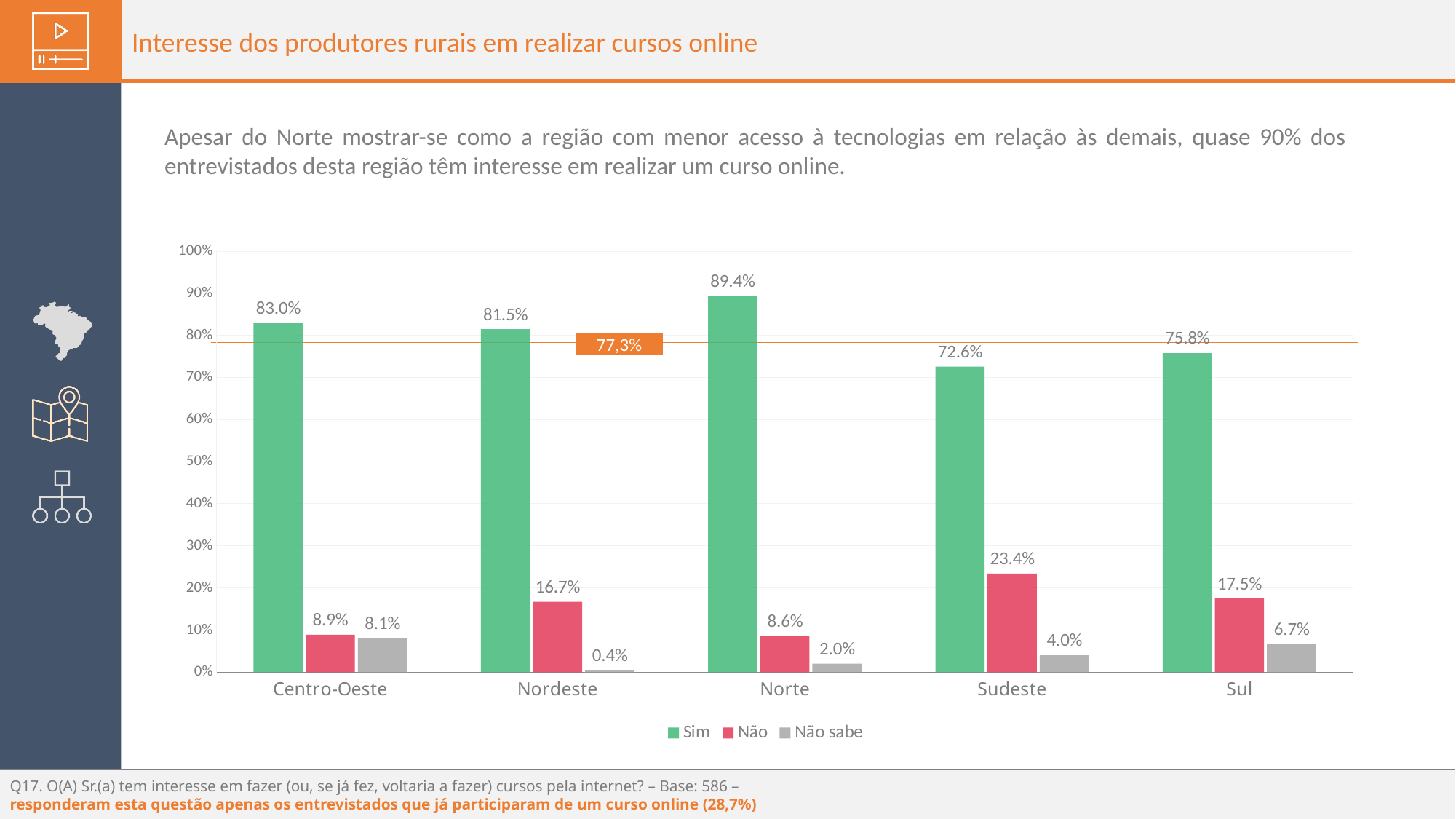
What is the value of "Não sabe" for Nordeste? 0.4% Which is larger, the "Não" value for Nordeste or for Sul? Sul How many regions are shown on the x axis? 5 Is the "Sim" value for Sudeste greater or less than 80%? less What kind of chart is shown on the slide? bar chart How many series does the legend list? 3 What is the value of "Sim" for Norte? 89.4% What is the value of "Não" for Sudeste? 23.4% Which region has the lowest "Sim" value? Sudeste What is the difference between the "Sim" values for Centro-Oeste and Sul? 7.2% What value is shown on the orange horizontal reference line? 77,3% Which region has the highest "Sim" value? Norte